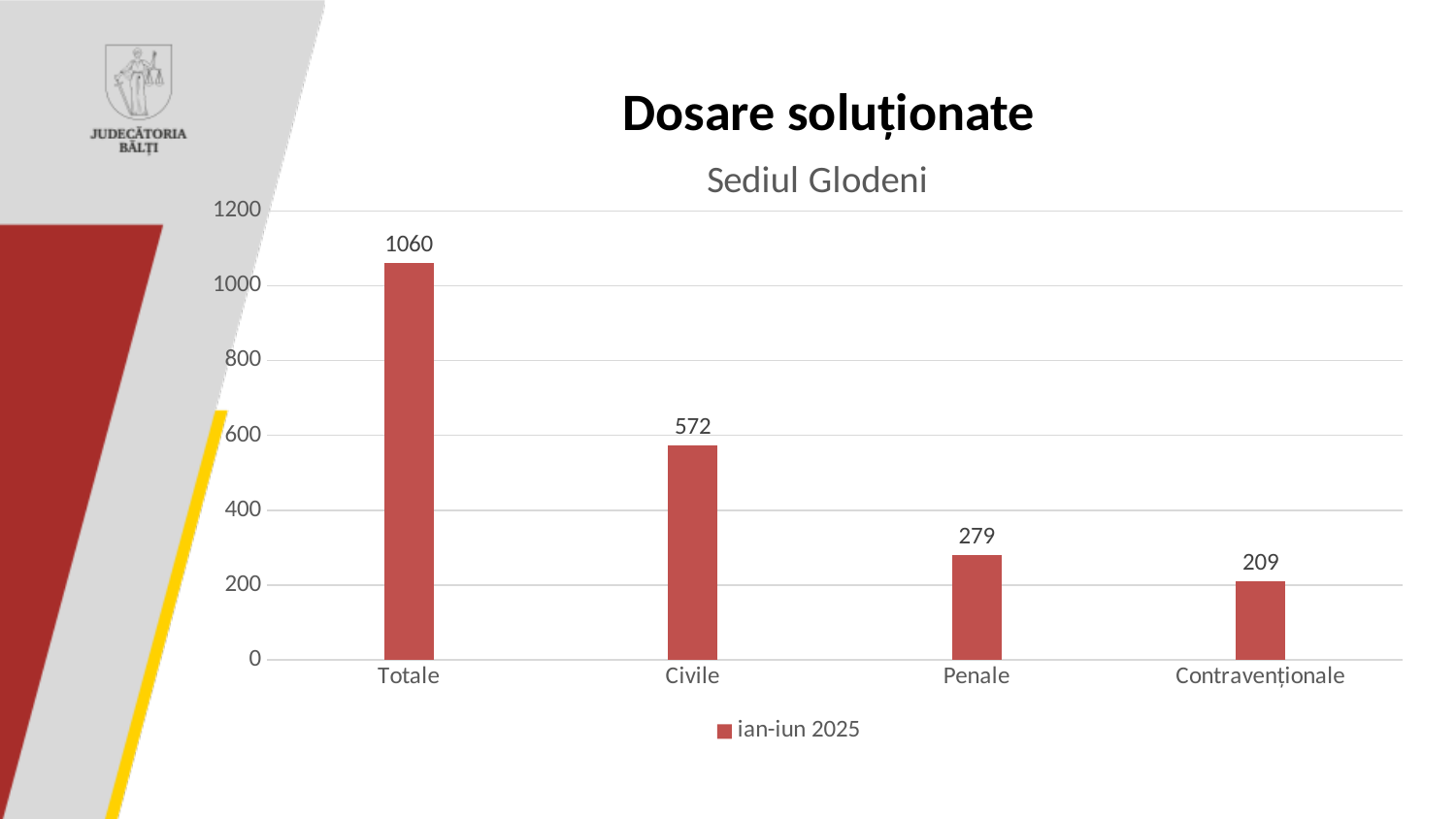
What is the value for Civile? 572 What is the value for Totale? 1060 Which category has the highest value? Totale What is the value for Contravenționale? 209 What kind of chart is shown on the slide? bar chart What is the value for Penale? 279 What is the difference between the values for Civile and Penale? 293 What series does the legend list? ian-iun 2025 Which category has the lowest value? Contravenționale Is the value for Civile greater or less than 600? less Which is larger, the value for Penale or the value for Contravenționale? Penale How many categories are shown on the x axis? 4